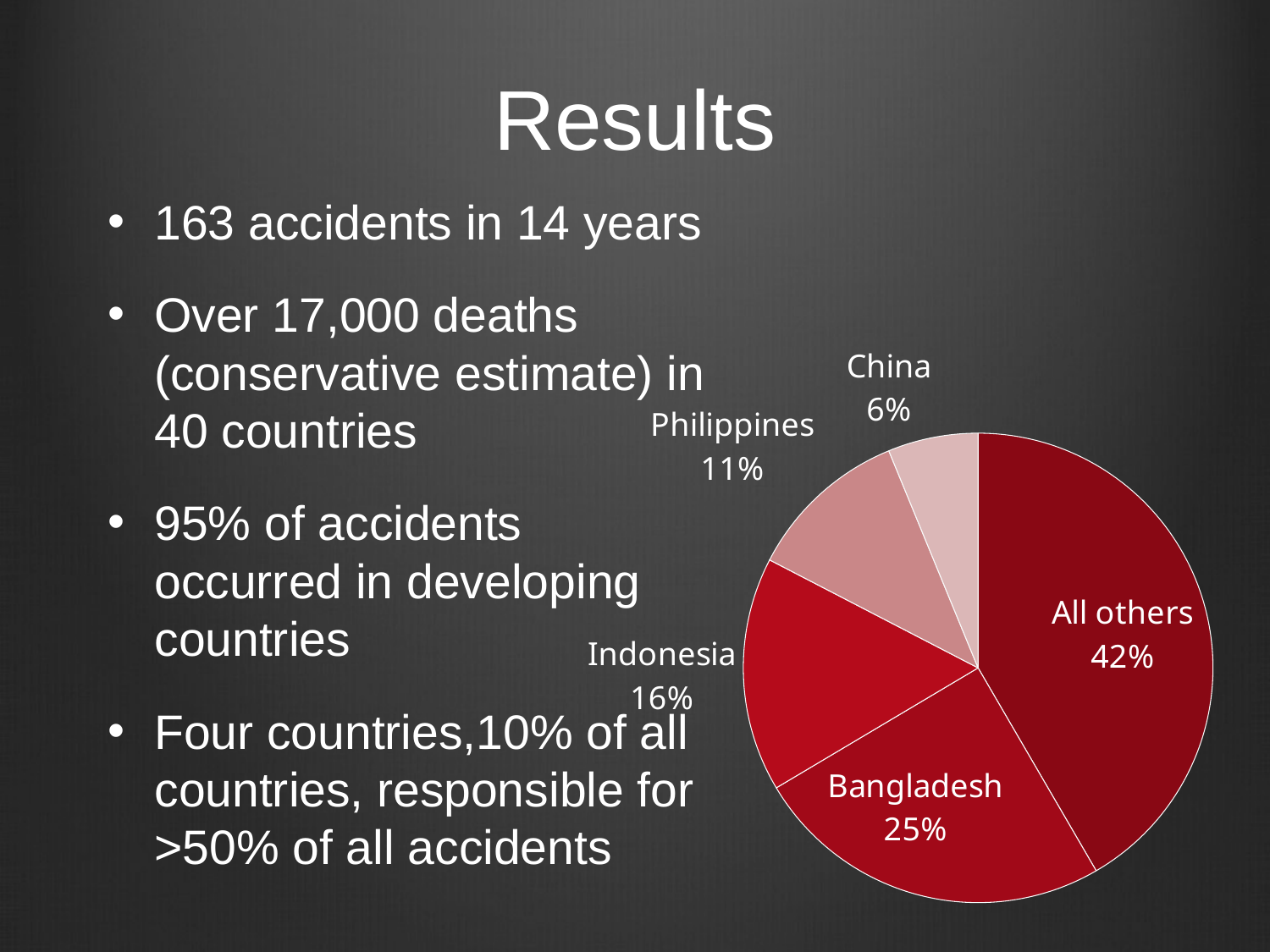
Which slice of the pie is the largest? All others What percentage is shown for Indonesia? 16% Which slice is labelled 42%? All others What is the combined share of Bangladesh, Indonesia, the Philippines and China? 58% What percentage is shown for the Philippines? 11% What type of chart is shown on the slide? Pie chart What percentage is shown for China? 6% How many slices does the pie chart have? 5 What share of the pie does Bangladesh account for? 25% Which slice of the pie is the smallest? China What is the difference in percentage points between Bangladesh and Indonesia? 9 Which has a larger share, the Philippines or China? Philippines